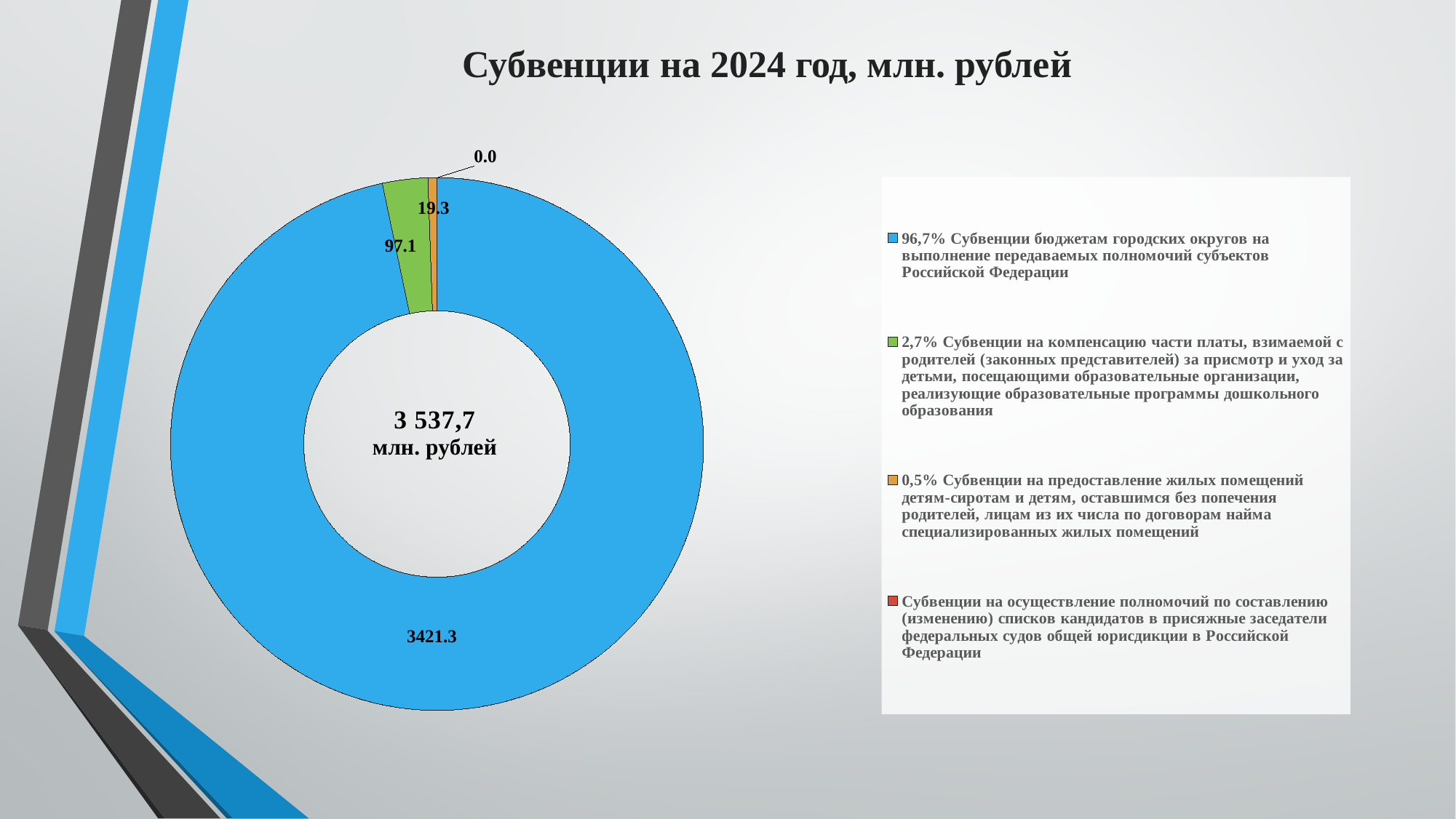
What is the difference between the value for 'Субвенции на компенсацию части платы' (97.1) and the value for 'Субвенции на предоставление жилых помещений детям-сиротам' (19.3)? 77.8 How many categories does the legend list? 4 What is the value for 'Субвенции на компенсацию части платы, взимаемой с родителей (законных представителей) за присмотр и уход за детьми'? 97.1 What share of the total do 'Субвенции бюджетам городских округов на выполнение передаваемых полномочий субъектов Российской Федерации' make up? 96,7% What is the value for 'Субвенции на предоставление жилых помещений детям-сиротам и детям, оставшимся без попечения родителей'? 19.3 What kind of chart is shown on the slide? pie chart (doughnut) What total amount is shown in the centre of the doughnut chart? 3 537,7 млн. рублей What is the value for 'Субвенции на осуществление полномочий по составлению (изменению) списков кандидатов в присяжные заседатели'? 0.0 What is the value for 'Субвенции бюджетам городских округов на выполнение передаваемых полномочий субъектов Российской Федерации'? 3421.3 What share of the total do 'Субвенции на компенсацию части платы, взимаемой с родителей' make up? 2,7% Which category has the smallest value? Субвенции на осуществление полномочий по составлению (изменению) списков кандидатов в присяжные заседатели федеральных судов общей юрисдикции в Российской Федерации Which category has the largest value? Субвенции бюджетам городских округов на выполнение передаваемых полномочий субъектов Российской Федерации